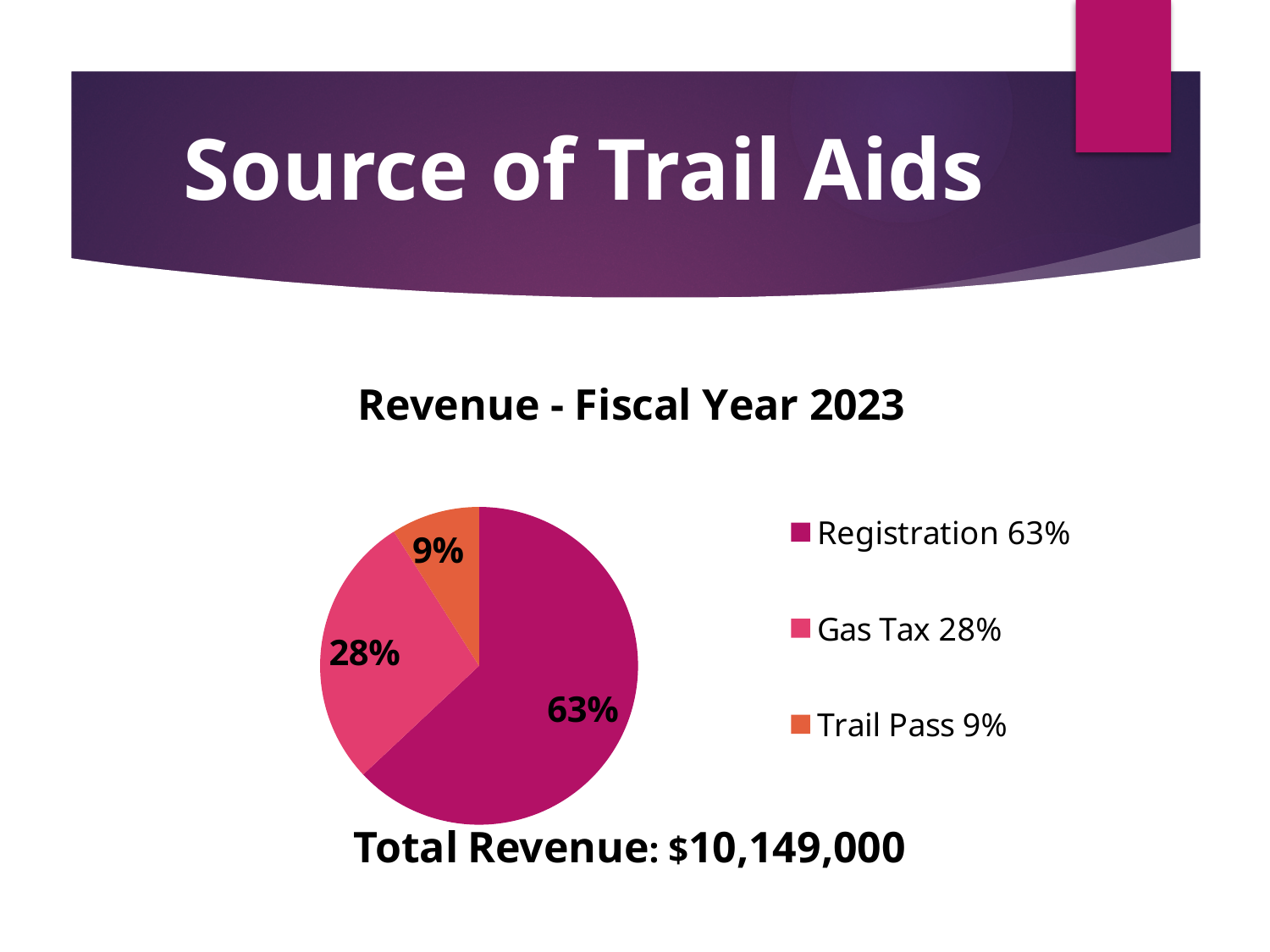
What is the difference in percentage points between the Registration and Gas Tax slices? 35 Which category has the largest slice of the pie? Registration What total revenue is stated below the chart? $10,149,000 Which is larger, the Gas Tax slice or the Trail Pass slice? Gas Tax What share of the pie does Trail Pass account for? 9% How many slices does the pie chart have? 3 What share of the pie does Gas Tax account for? 28% What share of the pie does Registration account for? 63% Which category has the smallest slice of the pie? Trail Pass What kind of chart is shown on the slide? Pie chart What is the difference in percentage points between the Gas Tax and Trail Pass slices? 19 What is the title of the chart? Revenue - Fiscal Year 2023